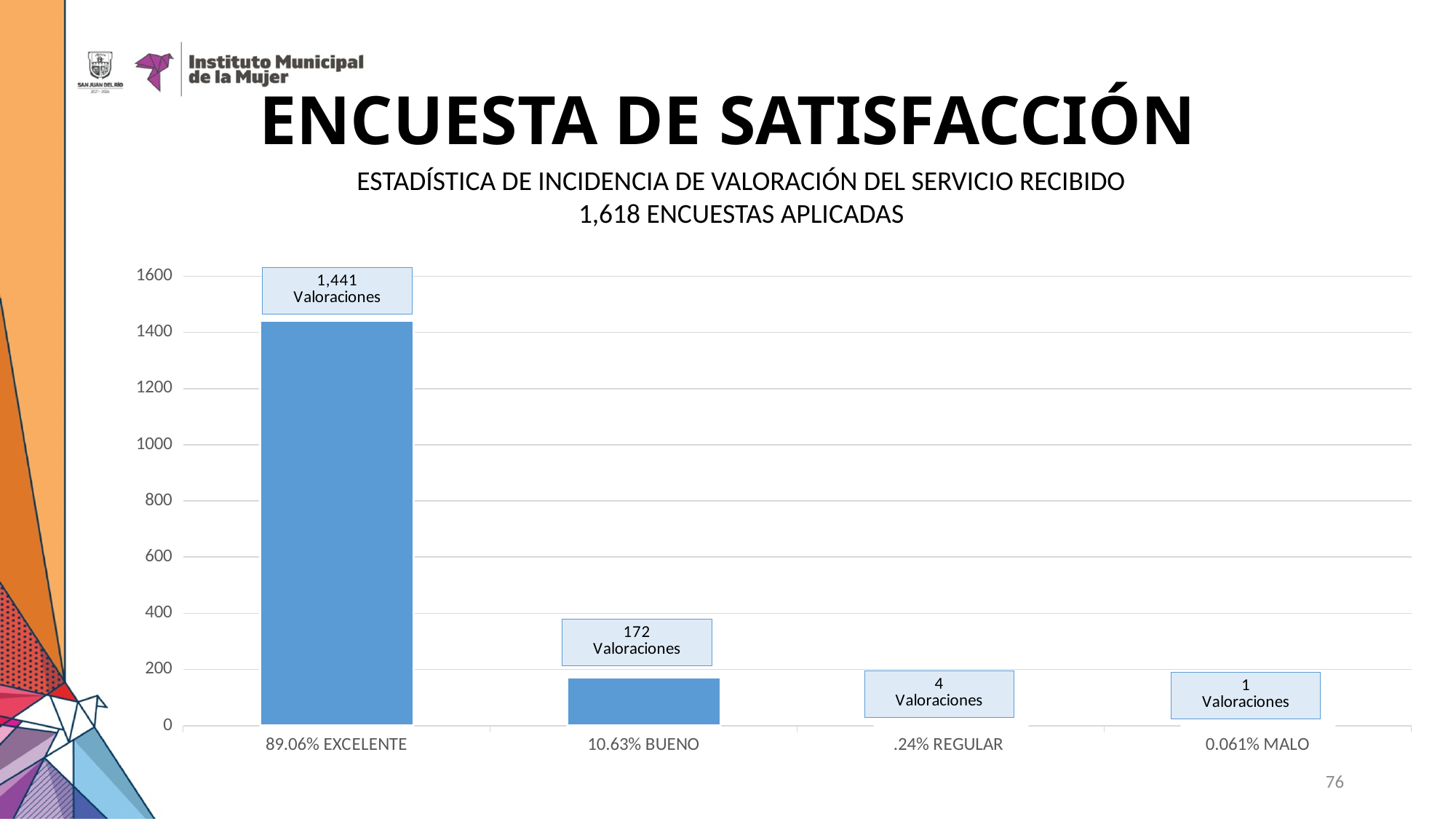
What is the difference in valoraciones between the EXCELENTE and BUENO categories? 1,269 Which category has the highest number of valoraciones? 89.06% EXCELENTE Which category has more valoraciones, BUENO or REGULAR? 10.63% BUENO Is the value for 10.63% BUENO greater or less than 200? less How many valoraciones does the chart show for the 10.63% BUENO category? 172 What kind of chart is shown on the slide? Bar chart Which category has the lowest number of valoraciones? 0.061% MALO How many valoraciones does the chart show for the .24% REGULAR category? 4 How many valoraciones does the chart show for the 89.06% EXCELENTE category? 1,441 How many valoraciones does the chart show for the 0.061% MALO category? 1 How many categories are shown on the x axis of the chart? 4 Do the values rise or fall from left to right along the x axis? Fall